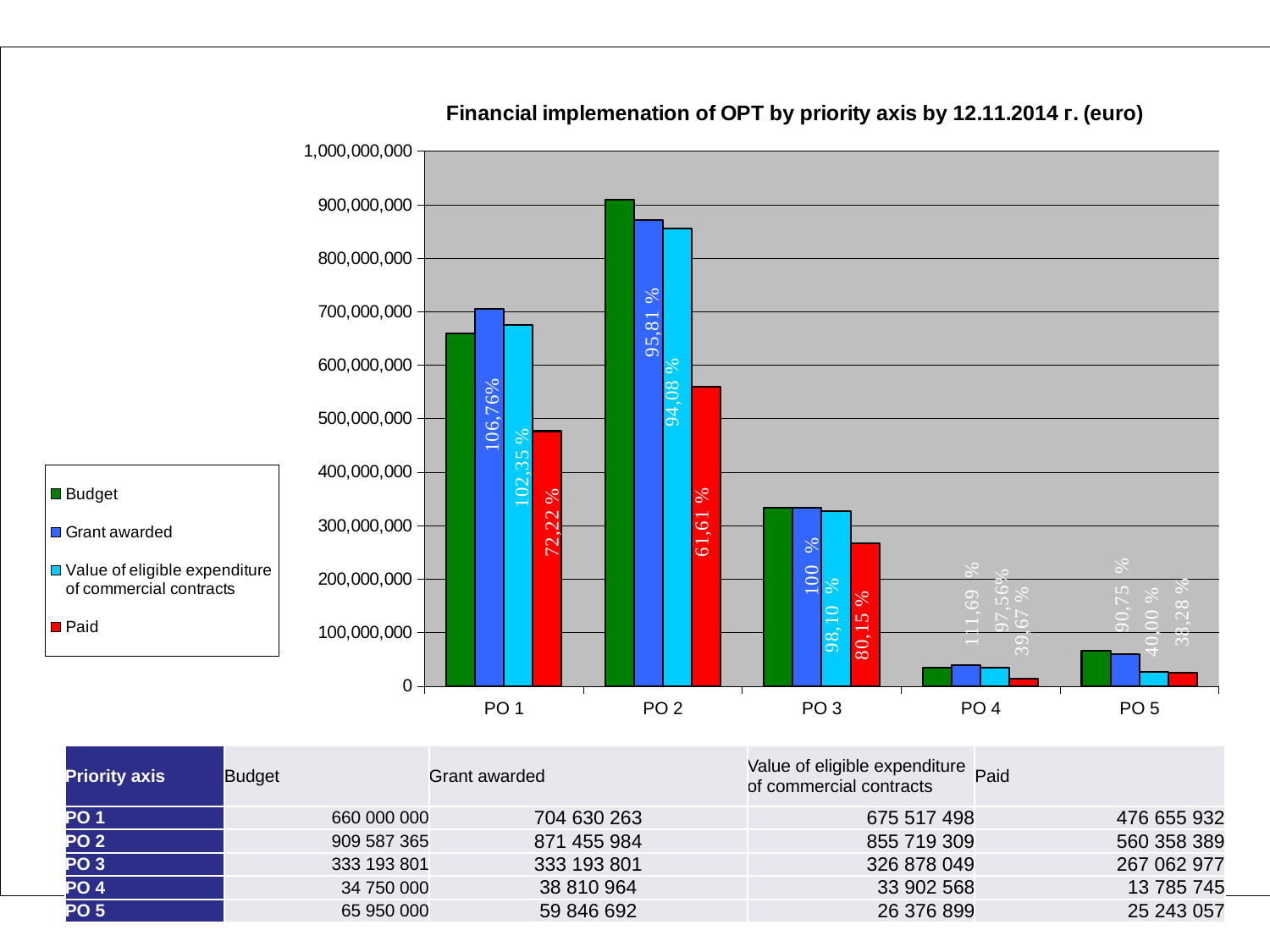
Which priority axis has the lowest Paid value? PO 4 What percentage label is shown on the Grant awarded bar for PO 1? 106,76% What percentage label is shown on the Paid bar for PO 3? 80,15 % What is the Paid value for PO 2? 560 358 389 Which priority axis has the highest Budget? PO 2 How many series does the legend list? 4 What is the title of the chart? Financial implemenation of OPT by priority axis by 12.11.2014 г. (euro) What kind of chart is shown on the slide? bar chart What is the difference between the Budget and the Paid value for PO 1? 183 344 068 For PO 1, which is larger: Budget or Grant awarded? Grant awarded How many priority axes are shown on the x axis of the chart? 5 Is the Budget value for PO 2 greater or less than 900,000,000? greater